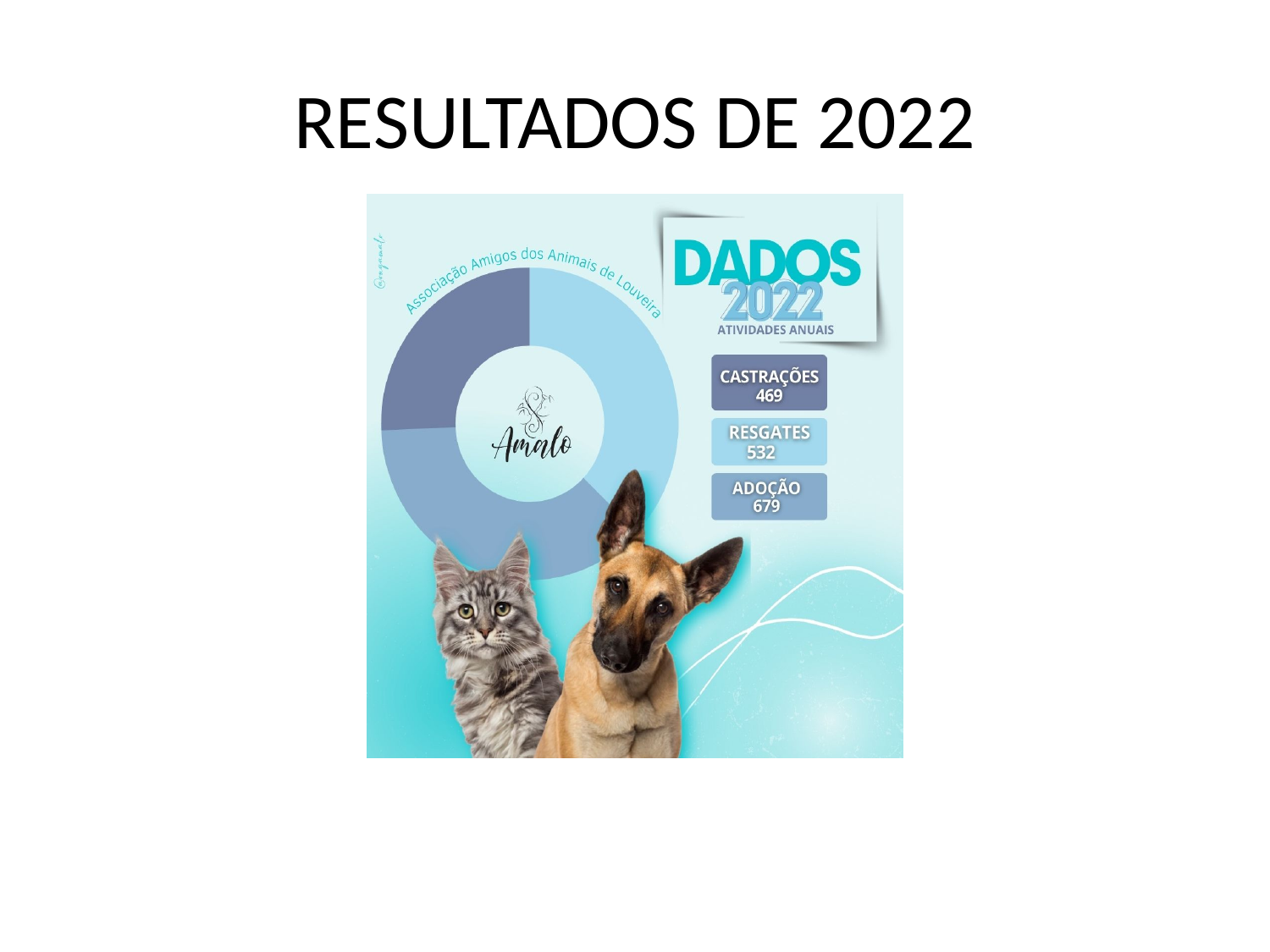
What is the difference between Adoção and Castrações? 210 How many categories does the chart show? 3 What is the value for Resgates? 532 Which category has the lowest value? Castrações What is the value for Castrações? 469 What kind of chart is shown on the slide? Donut (pie) chart What is the difference between Adoção and Resgates? 147 Which category has the highest value? Adoção What is the total of the three categories shown? 1680 What year do the data on the chart refer to? 2022 What is the value for Adoção? 679 Which is larger, Resgates or Castrações? Resgates